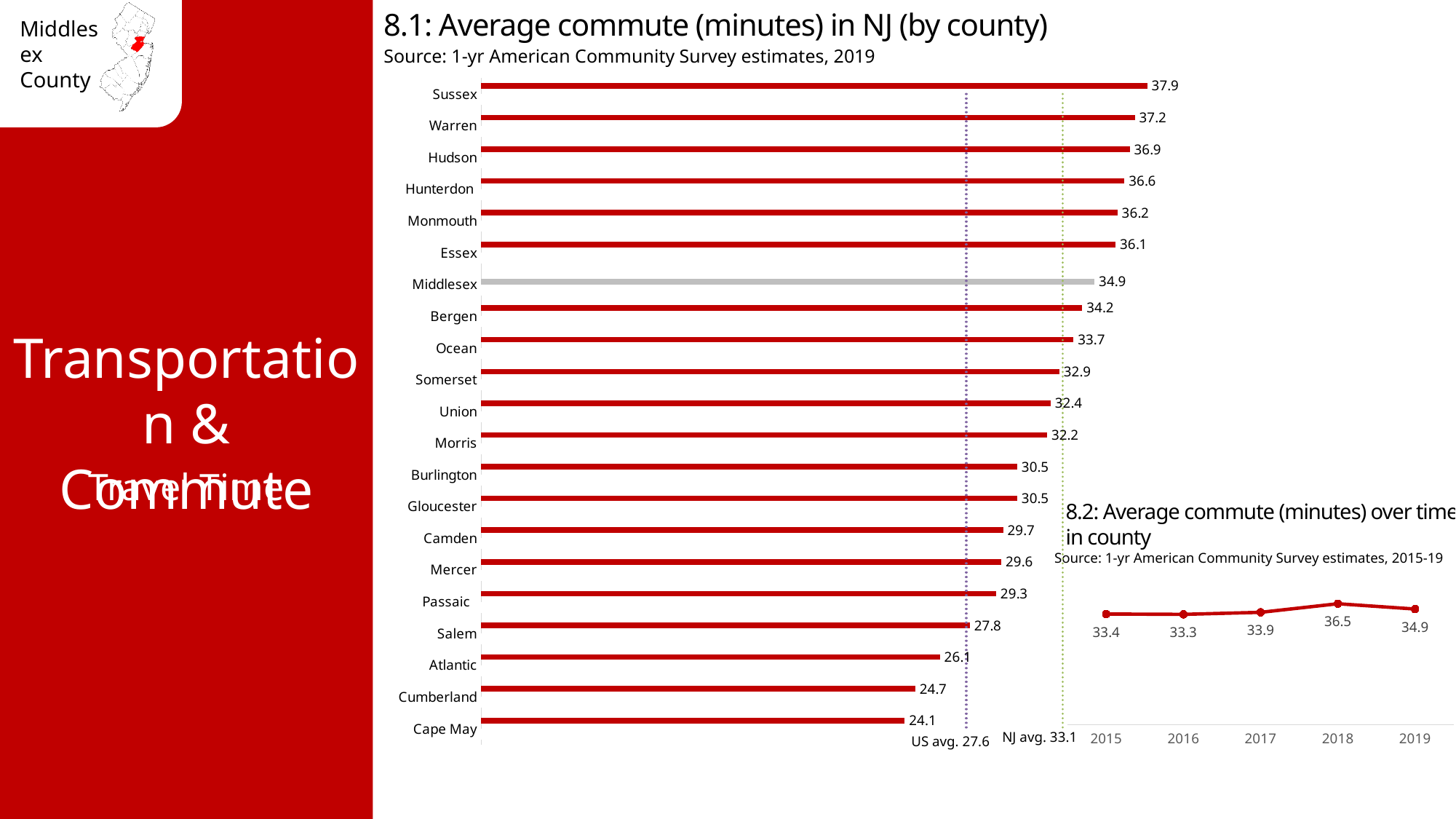
In chart 8.1 (Average commute in NJ by county), which county has the lowest average commute? Cape May In chart 8.1 (Average commute in NJ by county), what is the difference between Sussex and Cape May? 13.8 What kind of chart is chart 8.1 (Average commute in NJ by county)? Bar chart In chart 8.2 (Average commute over time in county), which year had the lowest average commute? 2016 In chart 8.2 (Average commute over time in county), what was the average commute in 2018? 36.5 In chart 8.1 (Average commute in NJ by county), how many counties are shown? 21 In chart 8.1 (Average commute in NJ by county), what is the average commute for Middlesex? 34.9 In chart 8.2 (Average commute over time in county), what is the difference between 2018 and 2019? 1.6 In chart 8.1 (Average commute in NJ by county), what value is shown for the NJ average reference line? 33.1 In chart 8.1 (Average commute in NJ by county), which county has the highest average commute? Sussex In chart 8.1 (Average commute in NJ by county), which has a longer average commute, Hudson or Bergen? Hudson In chart 8.1 (Average commute in NJ by county), what is the average commute for Salem? 27.8